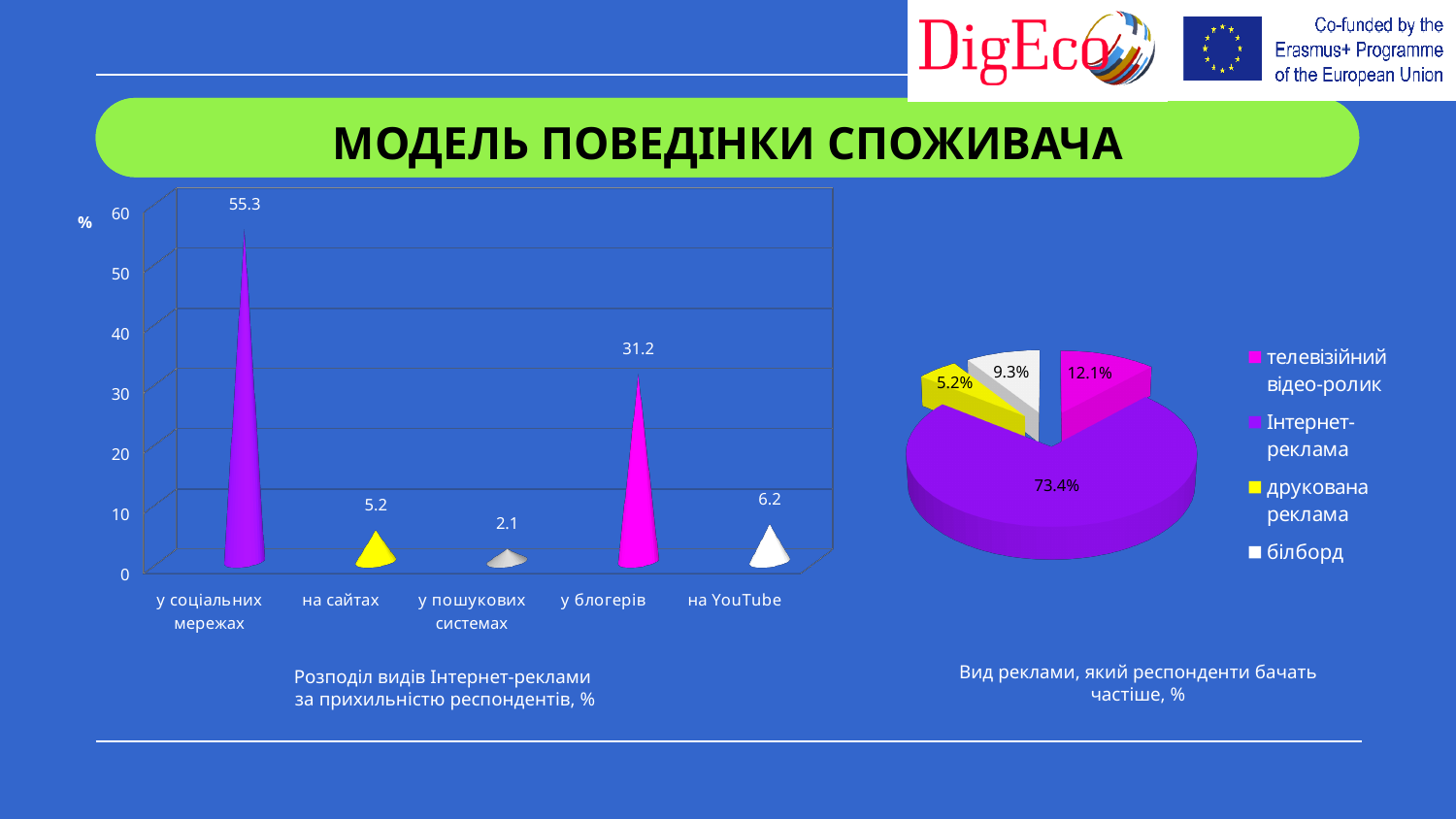
In the left chart (Розподіл видів Інтернет-реклами за прихильністю респондентів, %), what is the difference between the values for 'у соціальних мережах' and 'у блогерів'? 24.1 In the left chart (Розподіл видів Інтернет-реклами за прихильністю респондентів, %), what is the value for 'у соціальних мережах'? 55.3 How many categories are shown in the left chart (Розподіл видів Інтернет-реклами за прихильністю респондентів, %)? 5 In the left chart (Розподіл видів Інтернет-реклами за прихильністю респондентів, %), what is the value for 'у блогерів'? 31.2 In the right chart (Вид реклами, який респонденти бачать частіше, %), what share does 'Інтернет-реклама' have? 73.4% What type of chart is the right chart (Вид реклами, який респонденти бачать частіше, %)? pie chart In the right chart (Вид реклами, який респонденти бачать частіше, %), what is the value for 'білборд'? 9.3% In the right chart (Вид реклами, який респонденти бачать частіше, %), which category has the smallest slice? друкована реклама In the left chart (Розподіл видів Інтернет-реклами за прихильністю респондентів, %), which is larger: the value for 'на YouTube' or for 'на сайтах'? на YouTube How many entries does the legend of the right chart (Вид реклами, який респонденти бачать частіше, %) list? 4 In the left chart (Розподіл видів Інтернет-реклами за прихильністю респондентів, %), which category has the highest value? у соціальних мережах In the left chart (Розподіл видів Інтернет-реклами за прихильністю респондентів, %), which category has the lowest value? у пошукових системах